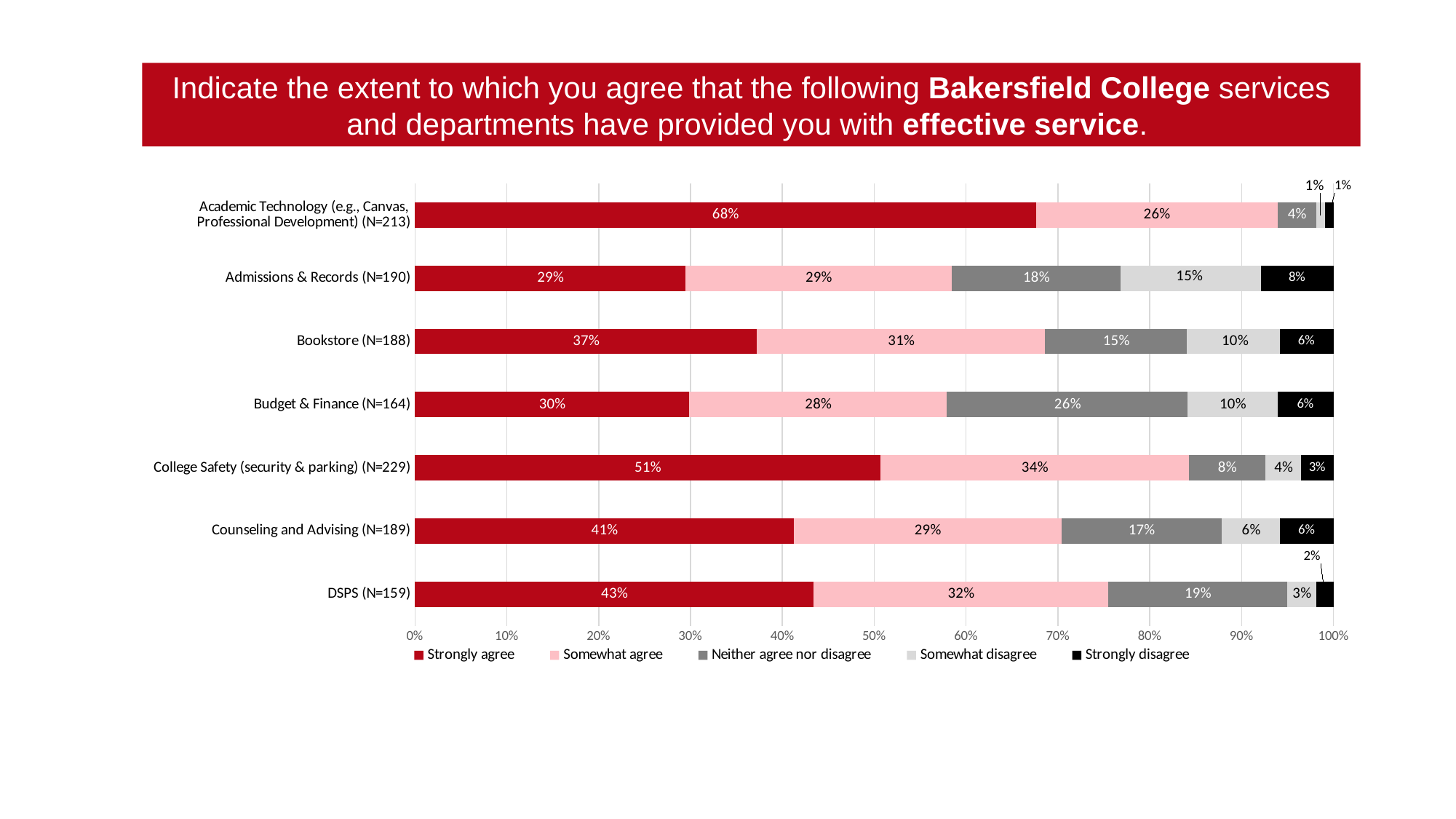
What is the Somewhat disagree percentage for Admissions & Records (N=190)? 15% How many response categories does the legend list? 5 What kind of chart is shown on the slide? Stacked bar chart Which has a larger Neither agree nor disagree percentage: Budget & Finance (N=164) or DSPS (N=159)? Budget & Finance (N=164) How many services or departments are shown in the chart? 7 What is the Strongly disagree percentage for Admissions & Records (N=190)? 8% Which service has the lowest Strongly agree percentage? Admissions & Records (N=190) What is the combined Strongly agree and Somewhat agree percentage for College Safety (security & parking) (N=229)? 85% Which service has the highest Strongly disagree percentage? Admissions & Records (N=190) How many percentage points higher is the Strongly agree value for Bookstore (N=188) than for Budget & Finance (N=164)? 7 percentage points What percentage of respondents strongly agree that Academic Technology (e.g., Canvas, Professional Development) provided effective service? 68% Which service has the highest Strongly agree percentage? Academic Technology (e.g., Canvas, Professional Development) (N=213)